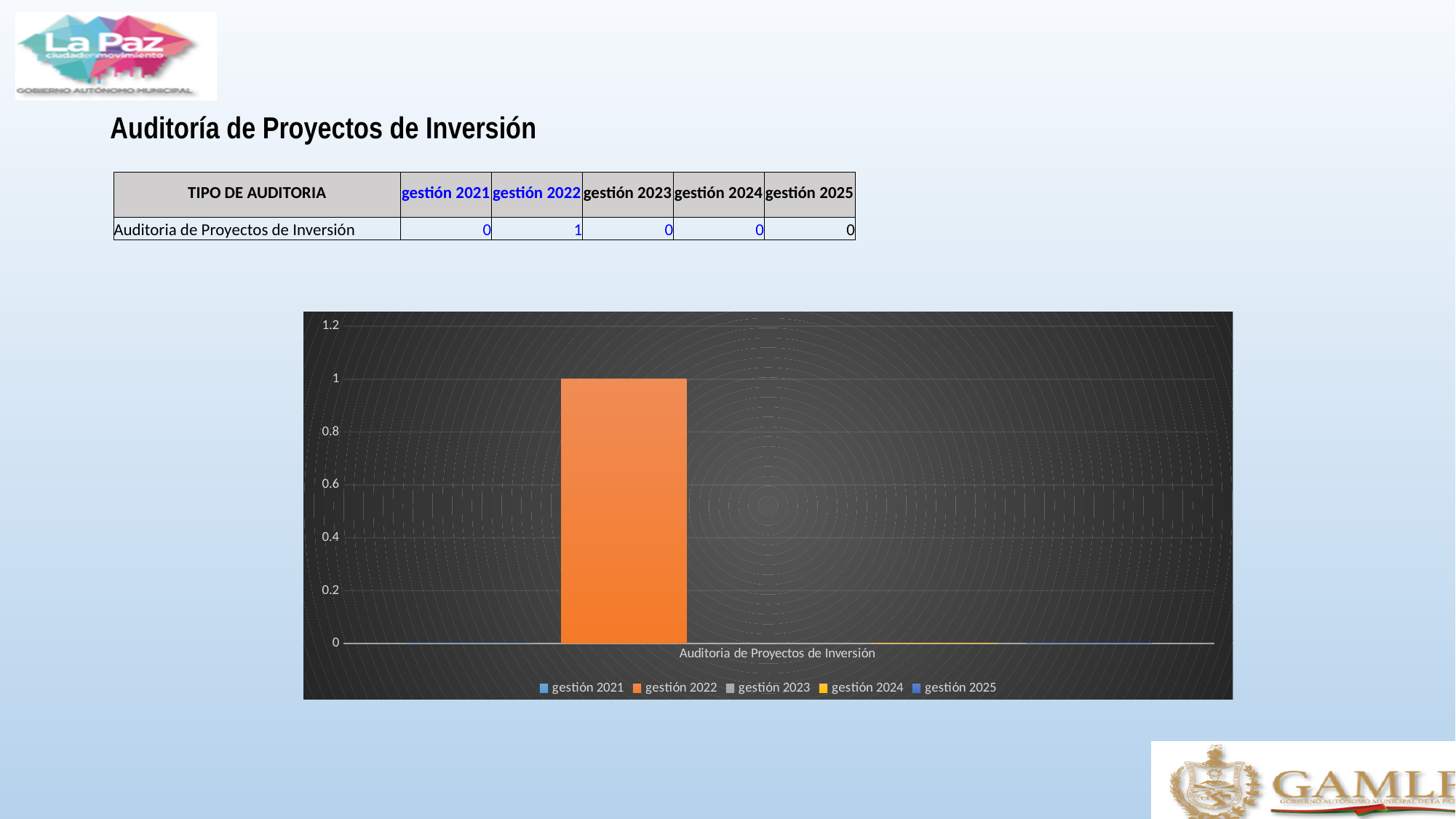
How many categories are shown on the x axis of the chart? 1 Is the value of the gestión 2022 bar greater or less than 0.8? greater What is the value for gestión 2025 for Auditoria de Proyectos de Inversión? 0 What is the category label shown on the x axis of the chart? Auditoria de Proyectos de Inversión What is the difference between the gestión 2022 value and the gestión 2024 value for Auditoria de Proyectos de Inversión? 1 What kind of chart is shown on the slide? bar chart What is the value for gestión 2021 for Auditoria de Proyectos de Inversión? 0 Which is larger for Auditoria de Proyectos de Inversión, gestión 2022 or gestión 2023? gestión 2022 What colour is the gestión 2022 series in the chart? orange Which series has the highest value for Auditoria de Proyectos de Inversión? gestión 2022 What is the value of the gestión 2022 bar for Auditoria de Proyectos de Inversión? 1 How many series does the chart legend list? 5